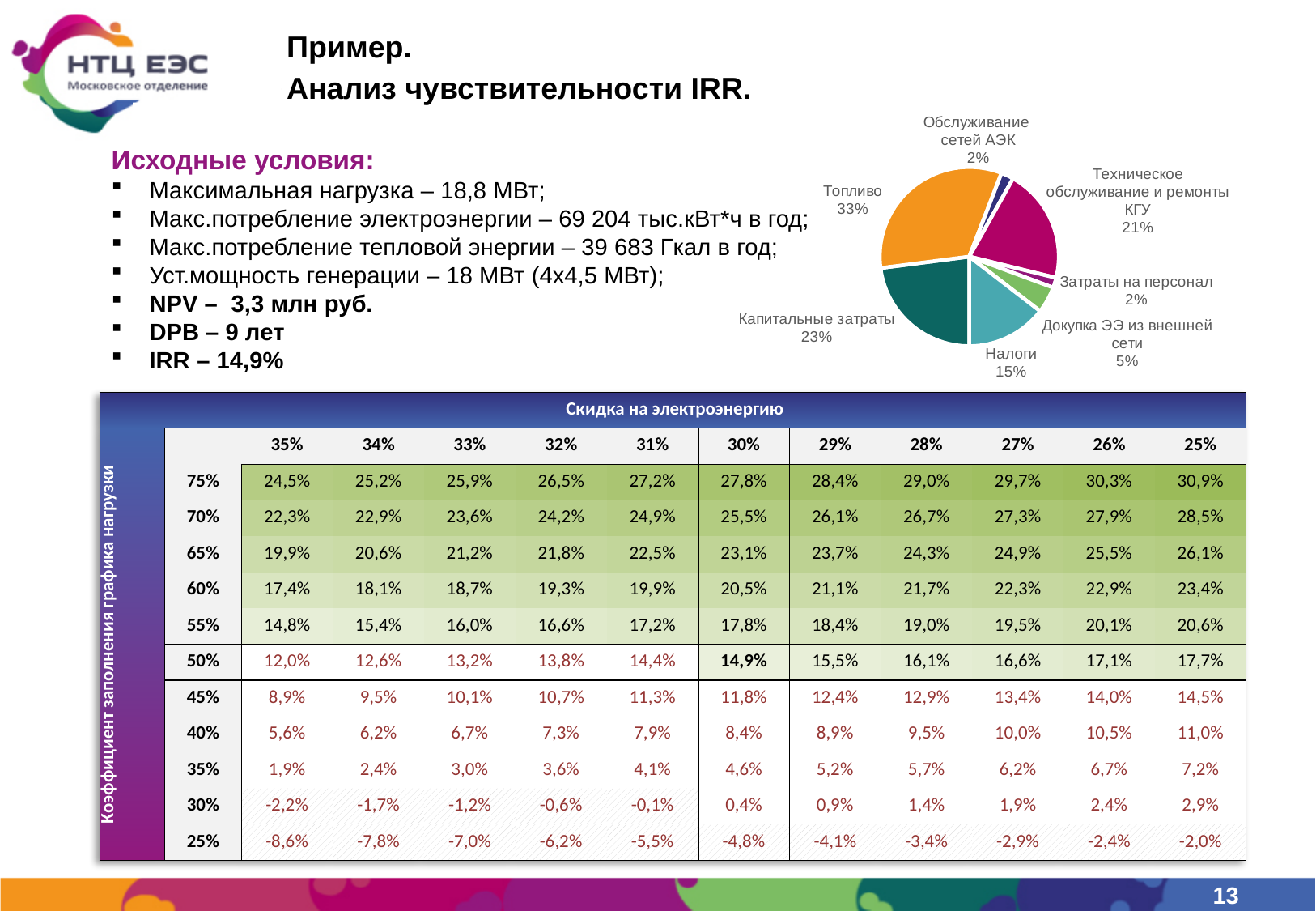
What kind of chart is shown on the slide? pie chart How many slices does the pie chart have? 7 Which slice of the pie chart is the largest? Топливо What share of the pie chart is Топливо? 33% Which is larger in the pie chart, Капитальные затраты or Налоги? Капитальные затраты What share of the pie chart is Затраты на персонал? 2% What share of the pie chart is Налоги? 15% What is the difference between the shares of Топливо and Капитальные затраты in the pie chart? 10 percentage points What is the difference between the shares of Техническое обслуживание и ремонты КГУ and Налоги in the pie chart? 6 percentage points What share of the pie chart is Капитальные затраты? 23% What share of the pie chart is Докупка ЭЭ из внешней сети? 5% What share of the pie chart is Техническое обслуживание и ремонты КГУ? 21%